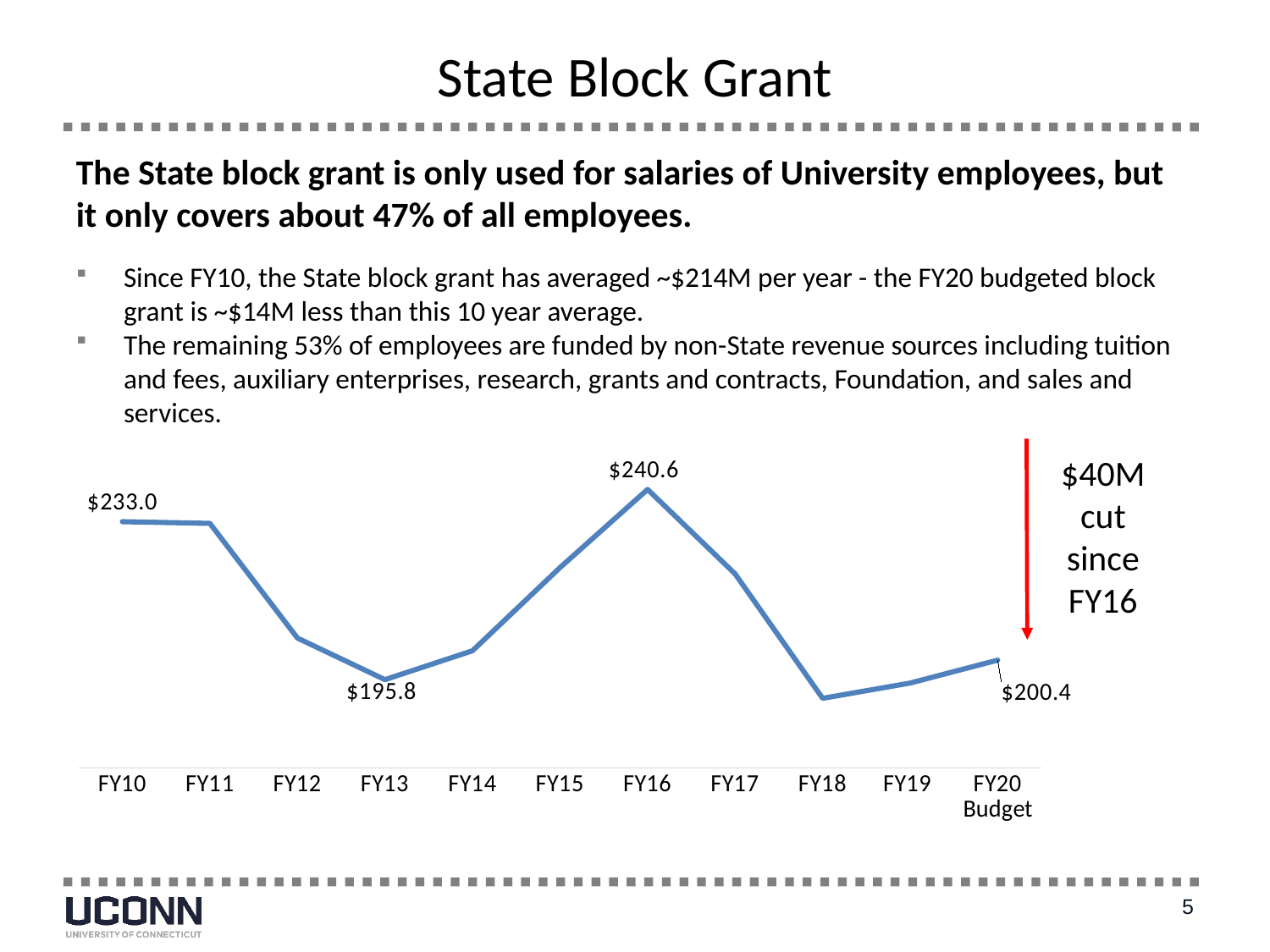
What is the difference between the FY10 value and the FY20 Budget value? $32.6 What is the value of the State block grant for FY10? $233.0 Which fiscal year has the lowest State block grant value? FY18 What is the difference between the FY16 value and the FY13 value? $44.8 Which fiscal year has the highest State block grant value? FY16 Which is larger, the value for FY10 or the value for FY20 Budget? FY10 What is the value of the State block grant for FY16? $240.6 How many fiscal years are plotted on the x axis? 11 Does the State block grant rise or fall from FY13 to FY16? Rise What is the value of the State block grant for FY20 Budget? $200.4 What type of chart is shown on the slide? Line chart What is the value of the State block grant for FY13? $195.8